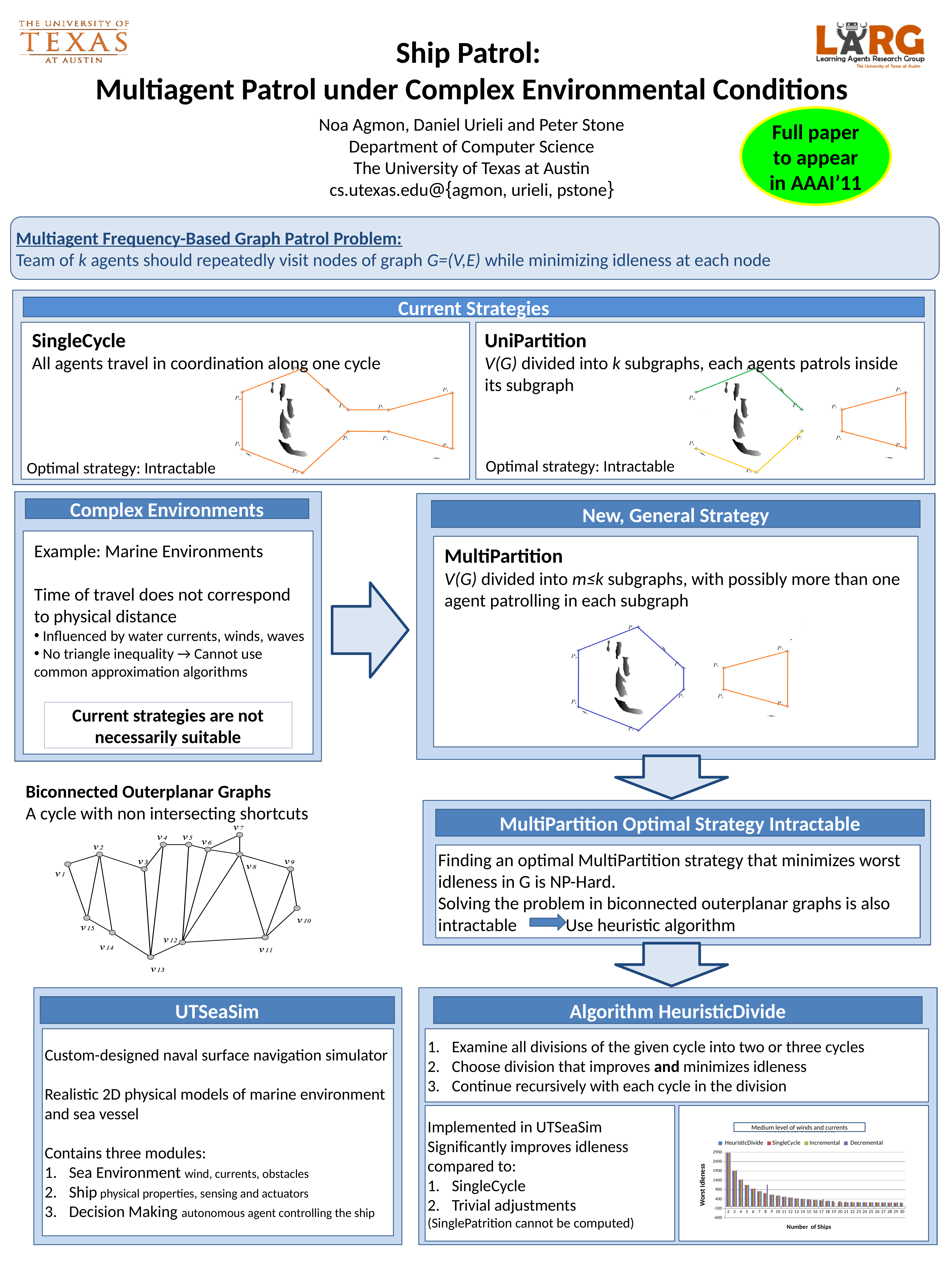
What is the label of the x axis of the 'Medium level of winds and currents' chart? Number of Ships Which series are listed in the legend of the 'Medium level of winds and currents' chart? HeuristicDivide, SingleCycle, Incremental, Decremental How many 'Number of Ships' categories are shown on the x axis of the 'Medium level of winds and currents' chart? 29 What is the title of the chart in the bottom-right panel? Medium level of winds and currents How many series does the legend of the 'Medium level of winds and currents' chart list? 4 In the 'Medium level of winds and currents' chart, which number of ships has the highest worst idleness? 2 In the 'Medium level of winds and currents' chart, are the bars at 30 ships greater or less than 400? less What kind of chart is shown in the bottom-right panel of the slide? bar chart In the 'Medium level of winds and currents' chart, do the worst idleness values generally rise or fall as the number of ships increases? fall In the 'Medium level of winds and currents' chart, is the tallest bar at 2 ships greater or less than 1900? greater In the 'Medium level of winds and currents' chart, is the worst idleness at 2 ships larger or smaller than at 20 ships? larger